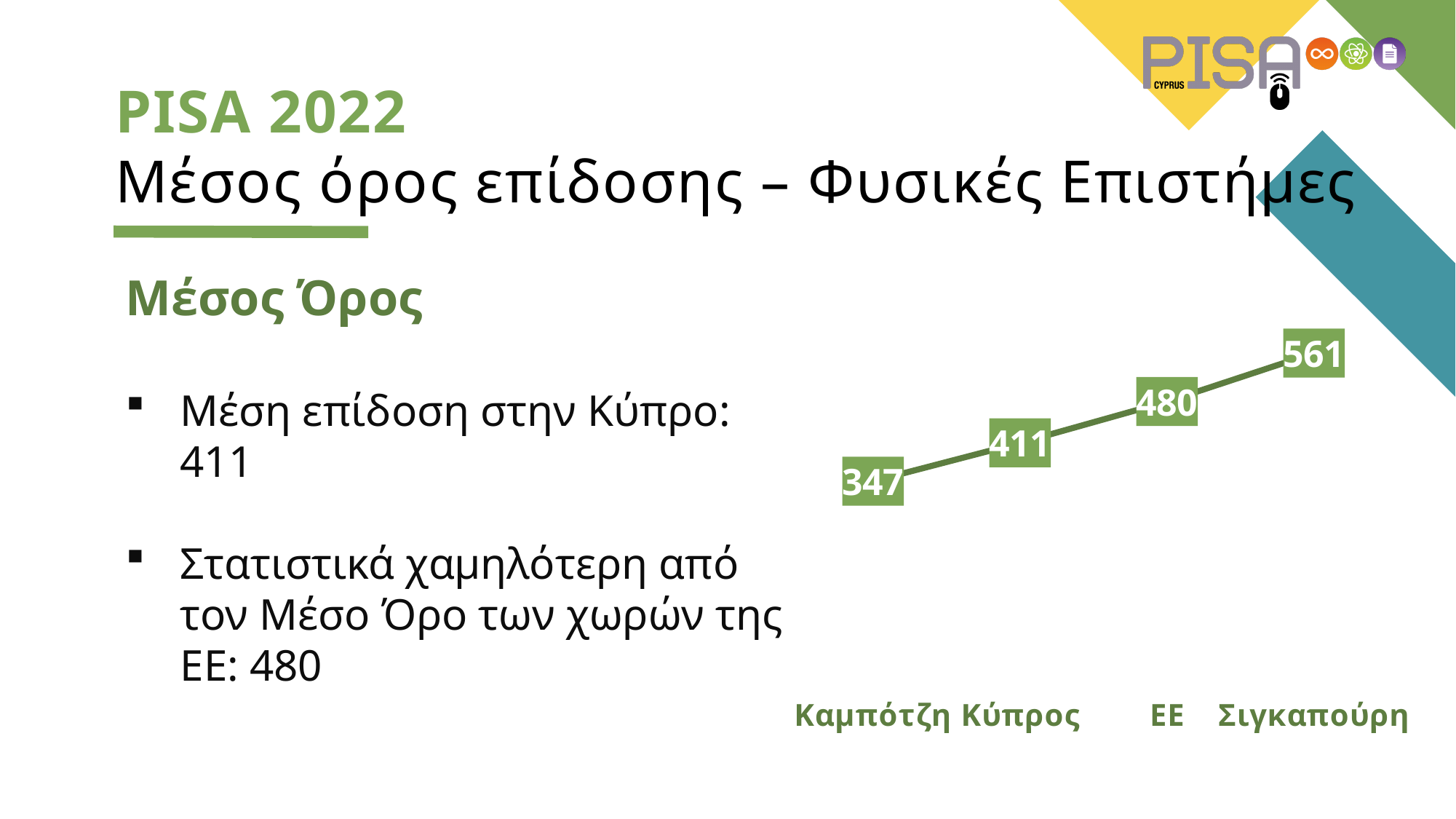
What is the difference between the values for ΕΕ and Κύπρος? 69 What is the value for Κύπρος (Cyprus) on the chart? 411 How many categories are plotted on the chart? 4 Do the values rise or fall from left to right along the x axis? rise Which is larger, the value for Κύπρος or the value for ΕΕ? ΕΕ Which category has the lowest value on the chart? Καμπότζη Which category has the highest value on the chart? Σιγκαπούρη What is the value for Σιγκαπούρη (Singapore) on the chart? 561 What is the value for ΕΕ (EU) on the chart? 480 What is the value for Καμπότζη (Cambodia) on the chart? 347 What is the difference between the values for Σιγκαπούρη and Καμπότζη? 214 What kind of chart is shown on the slide? line chart